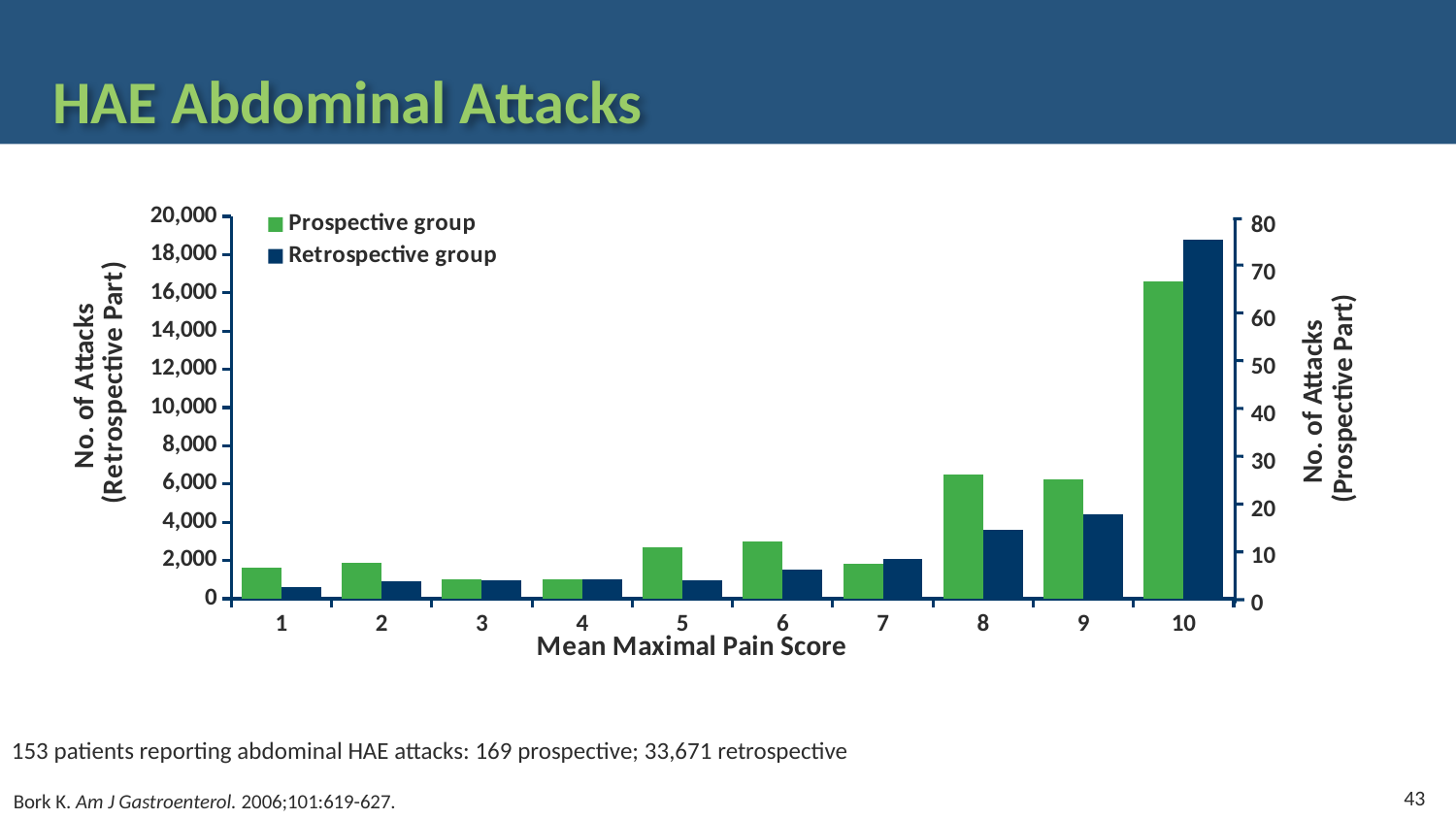
For the Retrospective group, which pain score has more attacks, 8 or 9? 9 Is the number of attacks for the Prospective group at pain score 8 greater or less than 20? greater Is the number of attacks for the Prospective group at pain score 10 greater or less than 60? greater Is the number of attacks for the Retrospective group at pain score 9 greater or less than 6,000? less At which mean maximal pain score is the number of attacks in the Prospective group highest? 10 How many pain score categories are shown on the x axis? 10 What is the title of the x axis? Mean Maximal Pain Score What kind of chart is shown on the slide? bar chart How many series does the legend list? 2 At which mean maximal pain score is the number of attacks in the Retrospective group lowest? 1 At which mean maximal pain score is the number of attacks in the Retrospective group highest? 10